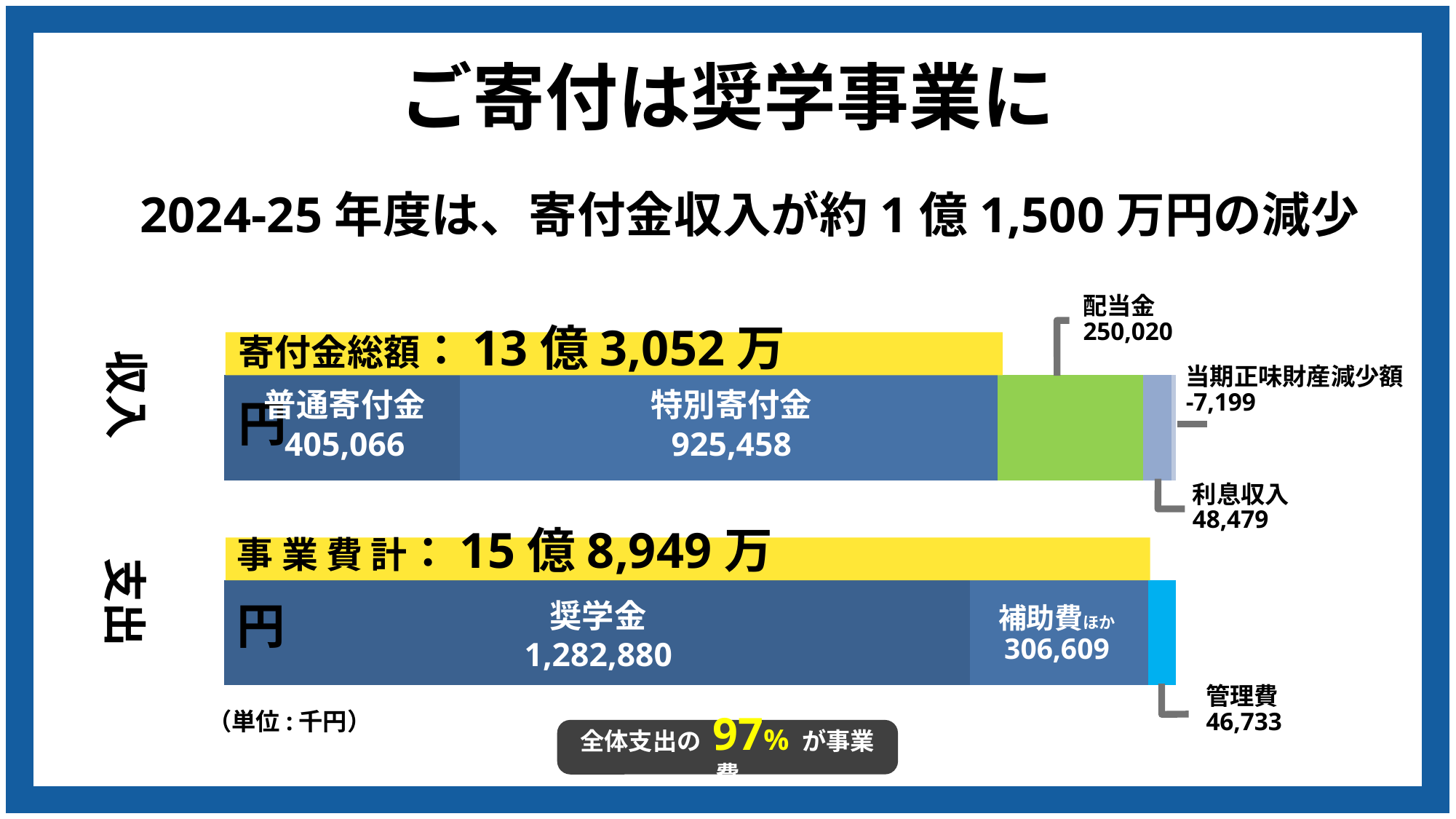
In the 収入 (income) bar, what is the value for 特別寄付金? 925,458 In the 収入 (income) bar, which segment has the largest value? 特別寄付金 In the 収入 (income) bar, what is the difference between 特別寄付金 and 普通寄付金? 520,392 In the 支出 (expenditure) bar, what is the value for 管理費? 46,733 In the 収入 (income) bar, what is the value for 普通寄付金? 405,066 In the 収入 (income) bar, which is larger, 配当金 or 利息収入? 配当金 In the 収入 (income) bar, what is the value for 配当金? 250,020 In the 支出 (expenditure) bar, what is the value for 奨学金? 1,282,880 What is the total of the 支出 (expenditure) stacked bar (奨学金 + 補助費ほか + 管理費)? 1,636,222 How many segments make up the 支出 (expenditure) bar? 3 In the 支出 (expenditure) bar, what is the difference between 奨学金 and 補助費ほか? 976,271 In the 支出 (expenditure) bar, which segment has the smallest value? 管理費